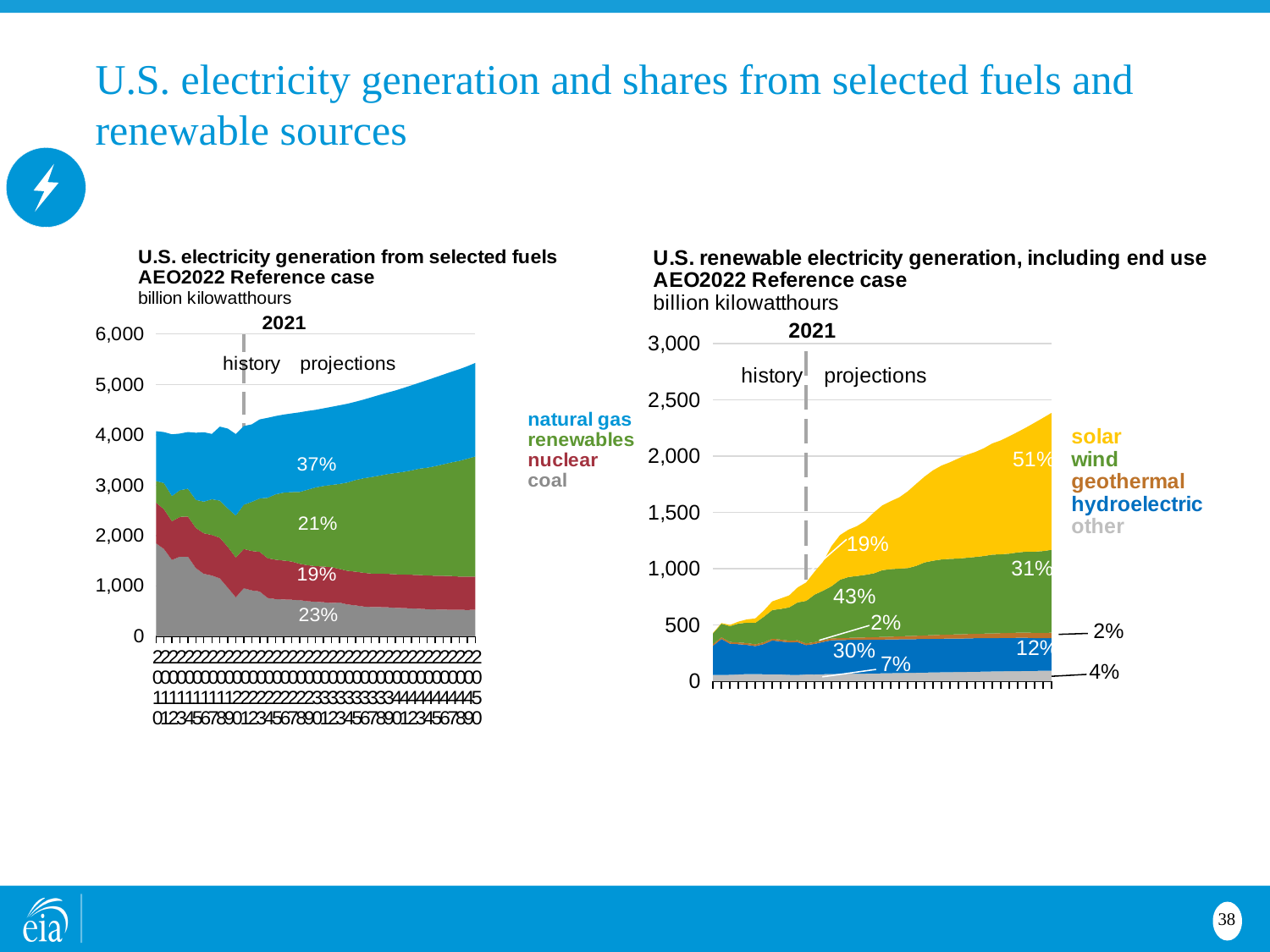
How many series does the legend of the left chart, 'U.S. electricity generation from selected fuels', list? 4 What kind of chart is the left chart, 'U.S. electricity generation from selected fuels'? stacked area chart In the left chart, 'U.S. electricity generation from selected fuels', what percentage label is shown on the coal area? 23% In the right chart, 'U.S. renewable electricity generation, including end use', what percentage label is shown for solar at the right edge of the chart? 51% In the left chart, 'U.S. electricity generation from selected fuels', what is the difference between the natural gas label (37%) and the renewables label (21%)? 16 percentage points In the left chart, 'U.S. electricity generation from selected fuels', is the total generation at the right end of the projections greater or less than 5,000 billion kilowatthours? greater In the left chart, 'U.S. electricity generation from selected fuels', which fuel has the largest percentage label? natural gas In the right chart, 'U.S. renewable electricity generation, including end use', does total renewable generation rise or fall over the projection period? rise In the left chart, 'U.S. electricity generation from selected fuels', what percentage label is shown on the natural gas area? 37% In the right chart, 'U.S. renewable electricity generation, including end use', what percentage label is shown for wind near the 2021 line? 43% In the right chart, 'U.S. renewable electricity generation, including end use', which is larger at the right edge: the solar label or the wind label? solar How many series does the legend of the right chart, 'U.S. renewable electricity generation, including end use', list? 5